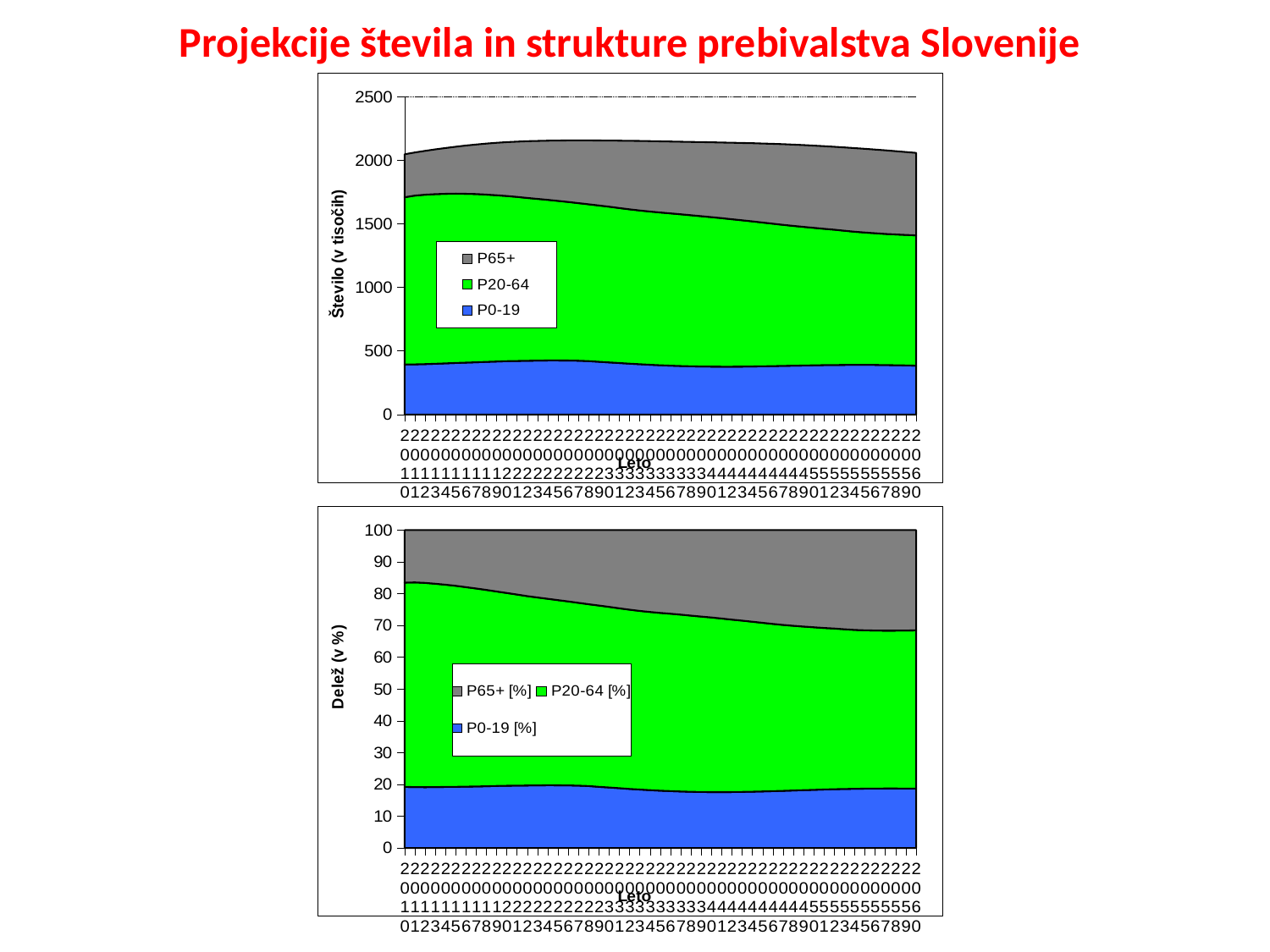
How many series does the legend of the bottom chart list? 3 In the bottom chart, does the share of P65+ [%] rise or fall from 2010 to 2060? rise Which colour represents the P0-19 series in the top chart? blue In the top chart, is the total population (top of the stacked areas) in 2010 greater or less than 2000? greater In the top chart, is the cumulative top of the P20-64 band in 2060 greater or less than 1500? less In the bottom chart, is the share of P0-19 [%] in 2060 greater or less than 30? less What kind of chart is the top chart on the slide? stacked area chart In the bottom chart, does the share of P20-64 [%] rise or fall from 2010 to 2060? fall How many series does the legend of the top chart list? 3 What is the y-axis title of the top chart? Število (v tisočih)